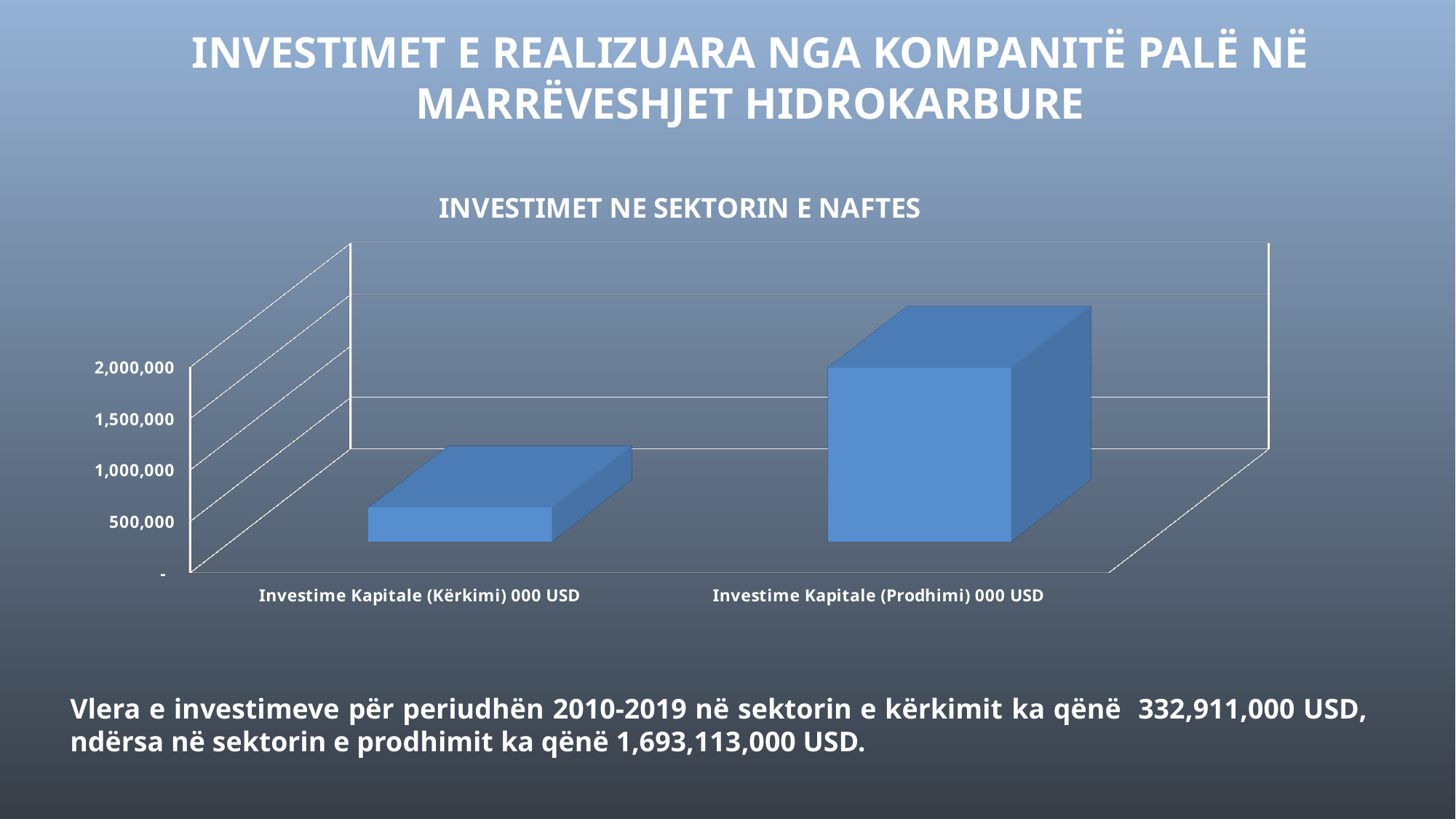
How many categories are plotted in the chart? 2 Is the value for Investime Kapitale (Prodhimi) greater or less than 500,000? greater Is the value for Investime Kapitale (Kërkimi) greater or less than 1,000,000? less What kind of chart is shown on the slide? bar chart What is the title of the chart? INVESTIMET NE SEKTORIN E NAFTES What is the highest tick value shown on the vertical axis of the chart? 2,000,000 Which is larger, the value for Investime Kapitale (Kërkimi) or for Investime Kapitale (Prodhimi)? Investime Kapitale (Prodhimi) Is the value for Investime Kapitale (Prodhimi) greater or less than 1,000,000? greater Which category has the lowest value in the chart? Investime Kapitale (Kërkimi) 000 USD Which category has the highest value in the chart? Investime Kapitale (Prodhimi) 000 USD